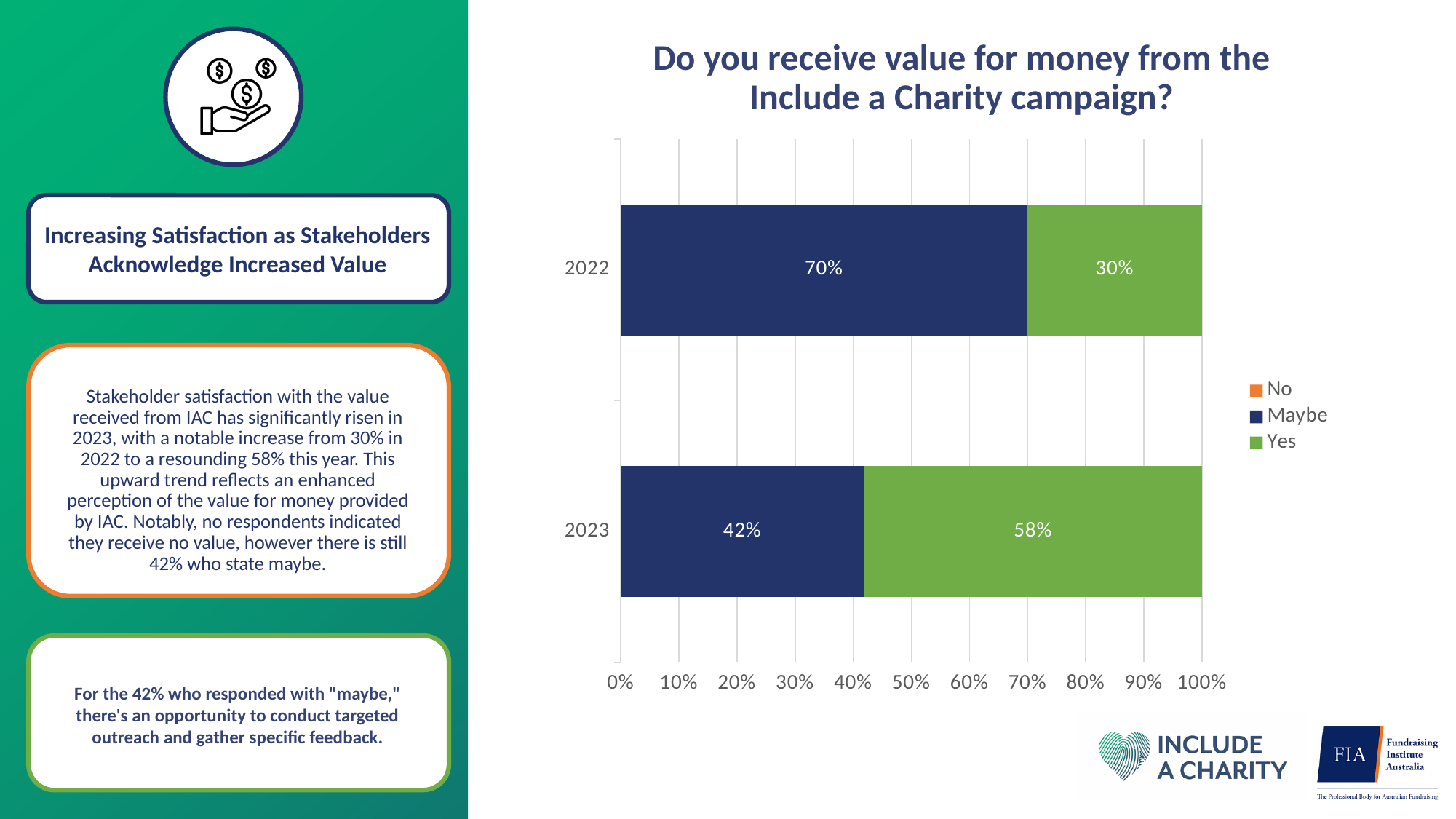
In 2023, which response was larger, "Yes" or "Maybe"? Yes How many years are shown on the chart? 2 In which year was the "Yes" share higher? 2023 By how many percentage points did the "Yes" share increase from 2022 to 2023? 28 percentage points How many series does the legend list? 3 In which year was the "Maybe" share lower? 2023 What type of chart is shown on the slide? Stacked bar chart What percentage of respondents answered "Maybe" in 2022? 70% What percentage of respondents answered "Yes" in 2022? 30% What is the title of the chart? Do you receive value for money from the Include a Charity campaign? What percentage of respondents answered "Maybe" in 2023? 42% What percentage of respondents answered "Yes" in 2023? 58%